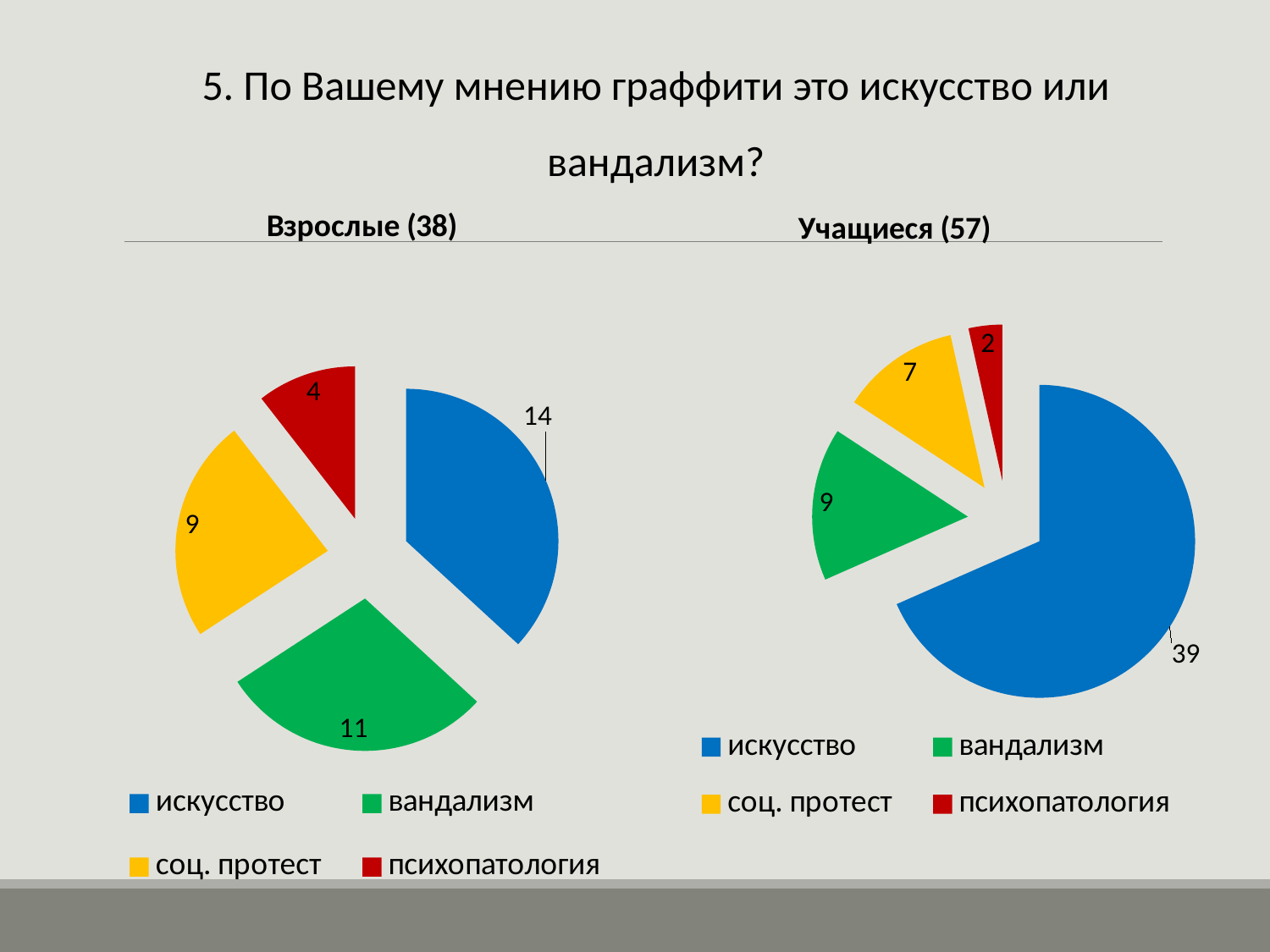
In the "Взрослые (38)" pie chart, what is the value for соц. протест? 9 In the "Взрослые (38)" pie chart, which category has the largest slice? искусство Which is larger: the value for вандализм in the "Взрослые (38)" chart or the value for вандализм in the "Учащиеся (57)" chart? Взрослые (38) What type of chart is used for "Взрослые (38)"? Pie chart In the "Учащиеся (57)" pie chart, what colour is the slice for соц. протест? Yellow In the "Учащиеся (57)" pie chart, what is the difference between the values for искусство and соц. протест? 32 In the "Учащиеся (57)" pie chart, what is the value for психопатология? 2 How many slices does the "Учащиеся (57)" pie chart have? 4 In the "Взрослые (38)" pie chart, what is the difference between the values for искусство and вандализм? 3 In the "Учащиеся (57)" pie chart, what is the value for вандализм? 9 In the "Учащиеся (57)" pie chart, which category has the smallest slice? психопатология In the "Взрослые (38)" pie chart, what is the value for искусство? 14